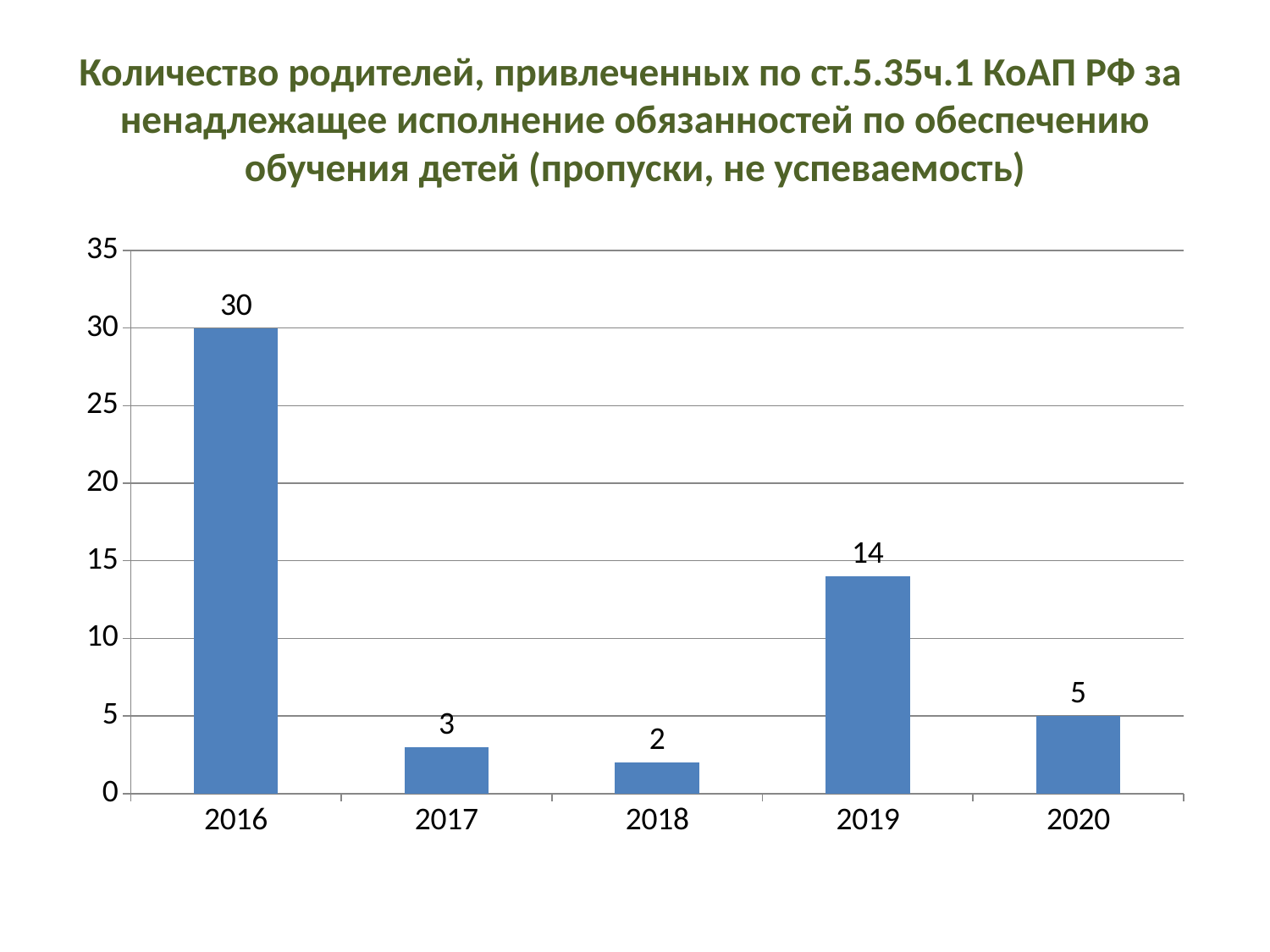
What is the difference between the values for 2016 and 2019? 16 What is the value for 2020? 5 Which is larger, the value for 2019 or the value for 2020? 2019 What kind of chart is shown on the slide? bar chart Which year has the highest value? 2016 What is the value for 2019? 14 Is the value for 2019 greater or less than 10? greater What is the difference between the values for 2017 and 2018? 1 How many years are shown on the x axis? 5 Which year has the lowest value? 2018 What is the value for 2016? 30 Do the values rise or fall from 2016 to 2018? fall